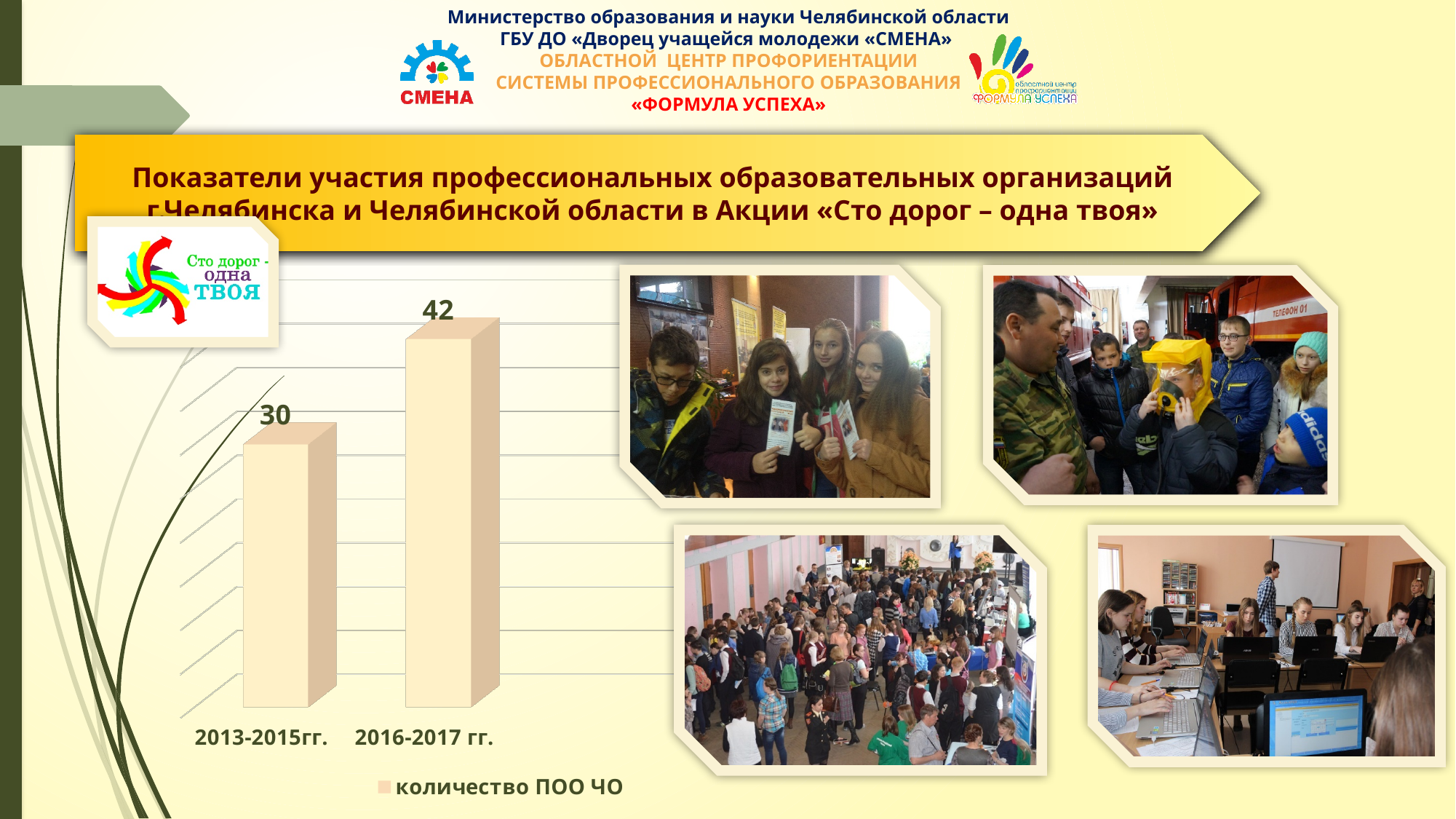
Do the values rise or fall from 2013-2015гг. to 2016-2017 гг.? rise What kind of chart is shown on the slide? bar chart What is the value for 2013-2015гг.? 30 How many categories are shown on the chart? 2 How many series does the legend list? 1 Which is larger, the value for 2013-2015гг. or for 2016-2017 гг.? 2016-2017 гг. Which period has the lowest value? 2013-2015гг. What is the difference between the values for 2016-2017 гг. and 2013-2015гг.? 12 Which period has the highest value? 2016-2017 гг. What series name is shown in the chart legend? количество ПОО ЧО What is the value for 2016-2017 гг.? 42